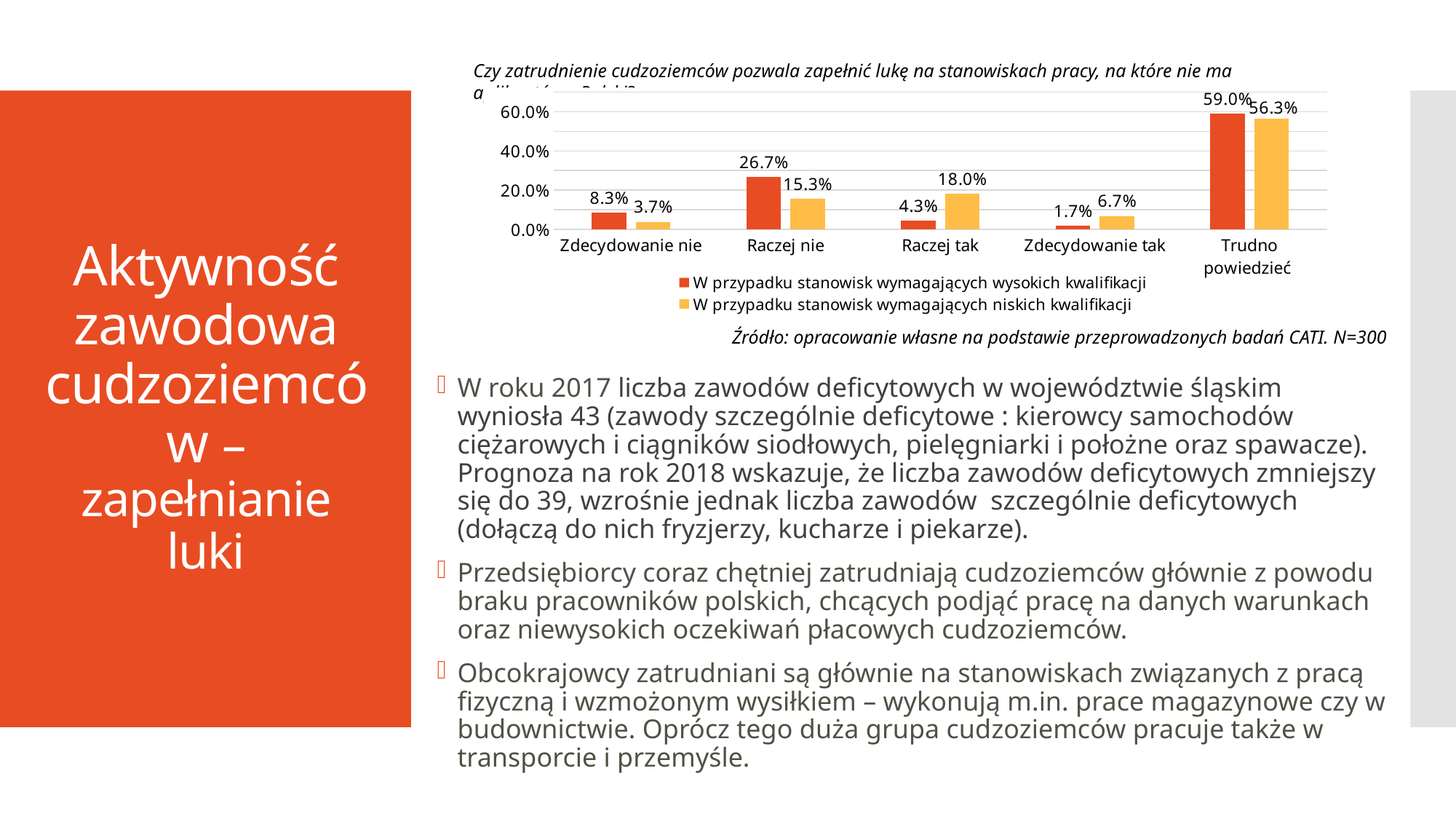
How many series does the chart's legend list? 2 Which category has the highest value in the series 'W przypadku stanowisk wymagających niskich kwalifikacji'? Trudno powiedzieć What value is shown for 'Raczej tak' in the series 'W przypadku stanowisk wymagających niskich kwalifikacji'? 18.0% What is the difference between the two series' values for 'Trudno powiedzieć'? 2.7% What value is shown for 'Raczej nie' in the series 'W przypadku stanowisk wymagających wysokich kwalifikacji'? 26.7% How many categories are shown on the x axis of the chart? 5 Which category has the lowest value in the series 'W przypadku stanowisk wymagających wysokich kwalifikacji'? Zdecydowanie tak What kind of chart is shown on the slide? Bar chart For 'Zdecydowanie nie', which series has the larger value? W przypadku stanowisk wymagających wysokich kwalifikacji What value is shown for 'Zdecydowanie tak' in the series 'W przypadku stanowisk wymagających wysokich kwalifikacji'? 1.7% What is the difference between the two series' values for 'Raczej nie'? 11.4% For 'Raczej tak', which series has the larger value? W przypadku stanowisk wymagających niskich kwalifikacji